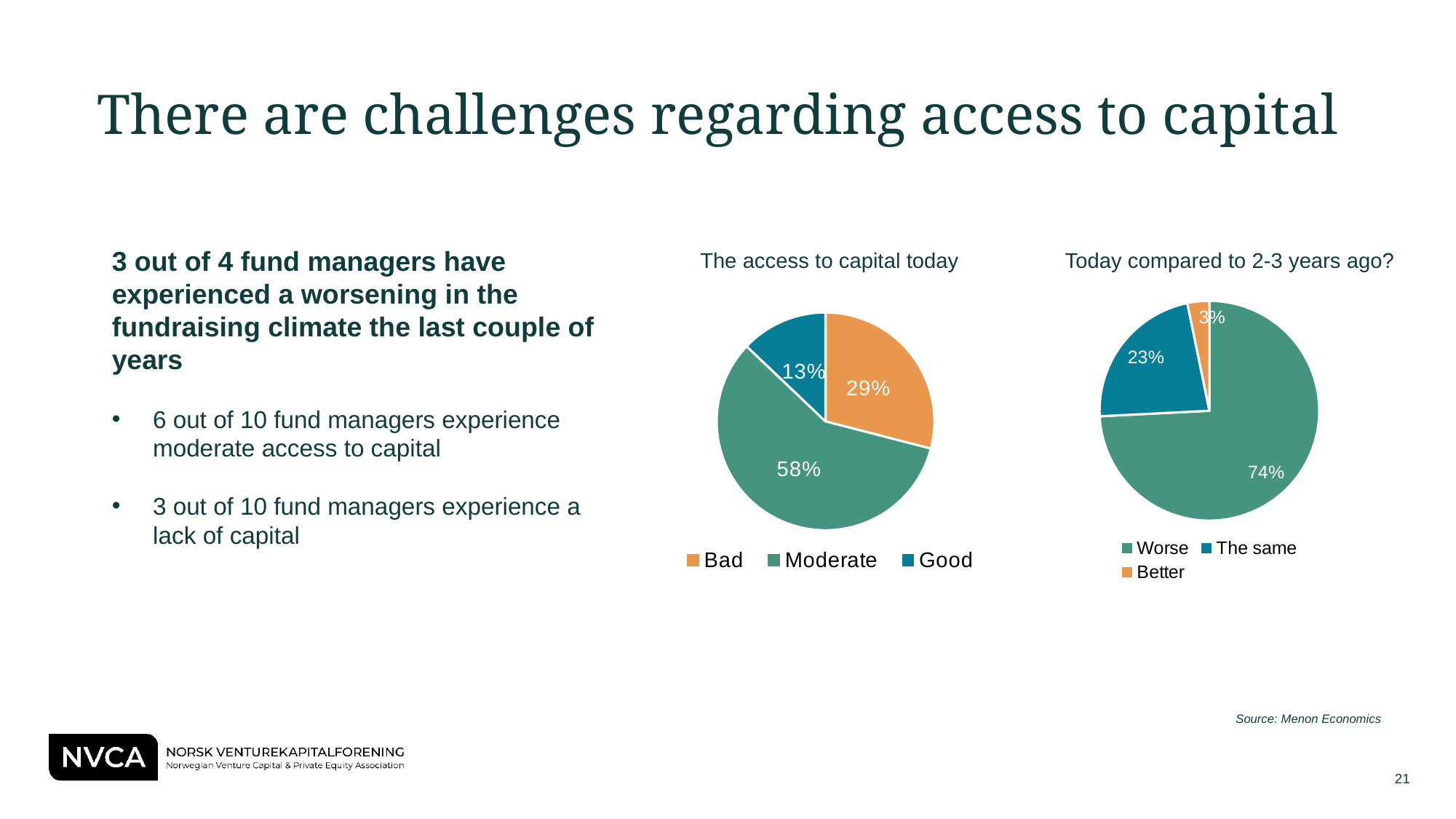
In the chart titled "Today compared to 2-3 years ago?", what share answered Worse? 74% In the chart titled "The access to capital today", what share of fund managers report moderate access to capital? 58% In the chart titled "The access to capital today", which category has the smallest slice? Good How many categories does the legend of the chart titled "Today compared to 2-3 years ago?" list? 3 In the chart titled "The access to capital today", what share is labelled Bad? 29% In the chart titled "Today compared to 2-3 years ago?", what share answered The same? 23% What type of chart is the chart titled "The access to capital today"? Pie chart In the chart titled "The access to capital today", what is the difference in percentage points between the Bad and Good slices? 16 percentage points In the chart titled "The access to capital today", which category has the largest slice? Moderate In the chart titled "Today compared to 2-3 years ago?", what share answered Better? 3% In the chart titled "The access to capital today", what share is labelled Good? 13% In the chart titled "Today compared to 2-3 years ago?", which is larger, the Worse slice or The same slice? Worse